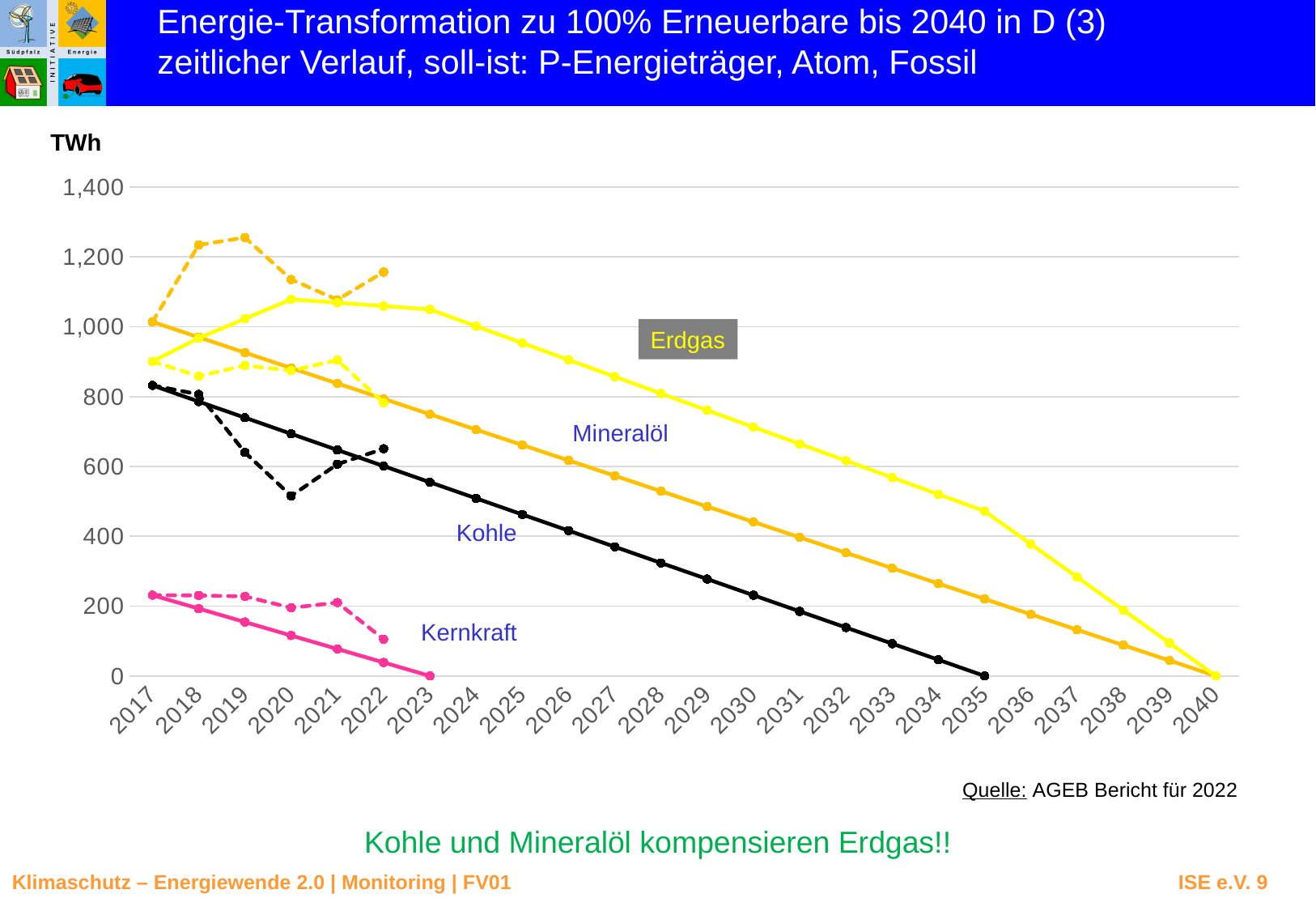
Does the solid Kohle line rise or fall from 2017 to 2035? fall In which year does the solid Kohle line reach 0 TWh? 2035 Is the dashed Kohle value for 2020 greater or less than 600? less Is the dashed Mineralöl value for 2019 greater or less than 1,200? greater Which energy carrier has the highest solid-line value in 2030? Erdgas What kind of chart is shown on the slide? line chart Which energy carrier has the lowest value in 2017? Kernkraft How many years are labelled along the x axis of the chart? 24 In which year does the solid Kernkraft line reach 0 TWh? 2023 In which year do the solid Erdgas and Mineralöl lines reach 0 TWh? 2040 Is the solid Erdgas value for 2020 greater or less than 1,000? greater What unit is shown on the y axis of the chart? TWh